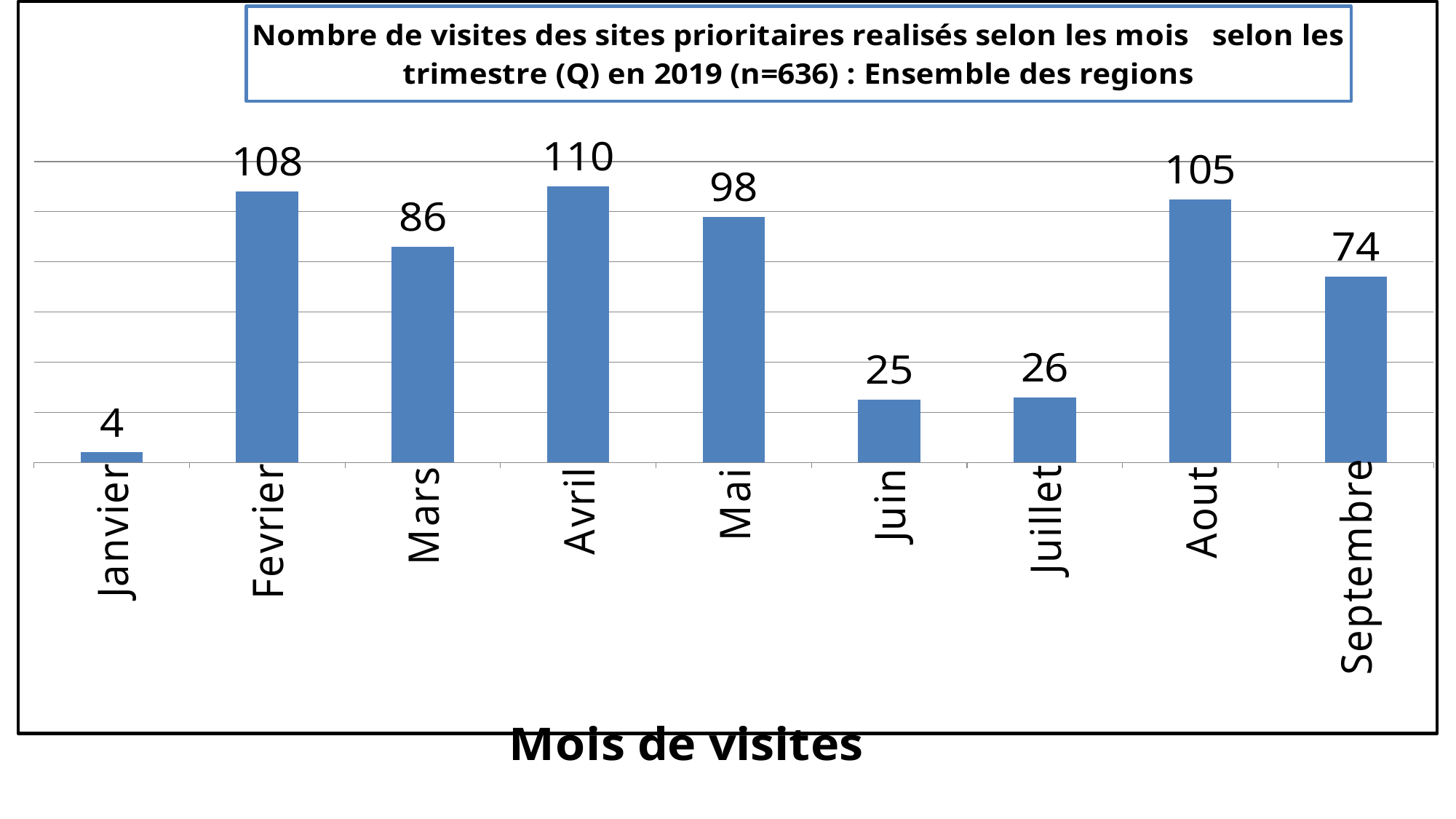
What is the difference between the visits in Fevrier and Mars? 22 What is the difference between the visits in Juillet and Juin? 1 What kind of chart is shown on the slide? Bar chart Do the visits rise or fall from Avril to Juin? Fall How many months are shown on the chart? 9 What is the number of visits in Avril? 110 What is the x-axis title of the chart? Mois de visites Which month has more visits, Mai or Aout? Aout What is the number of visits in Janvier? 4 Which month has the highest number of visits? Avril Which month has the lowest number of visits? Janvier What is the number of visits in Septembre? 74